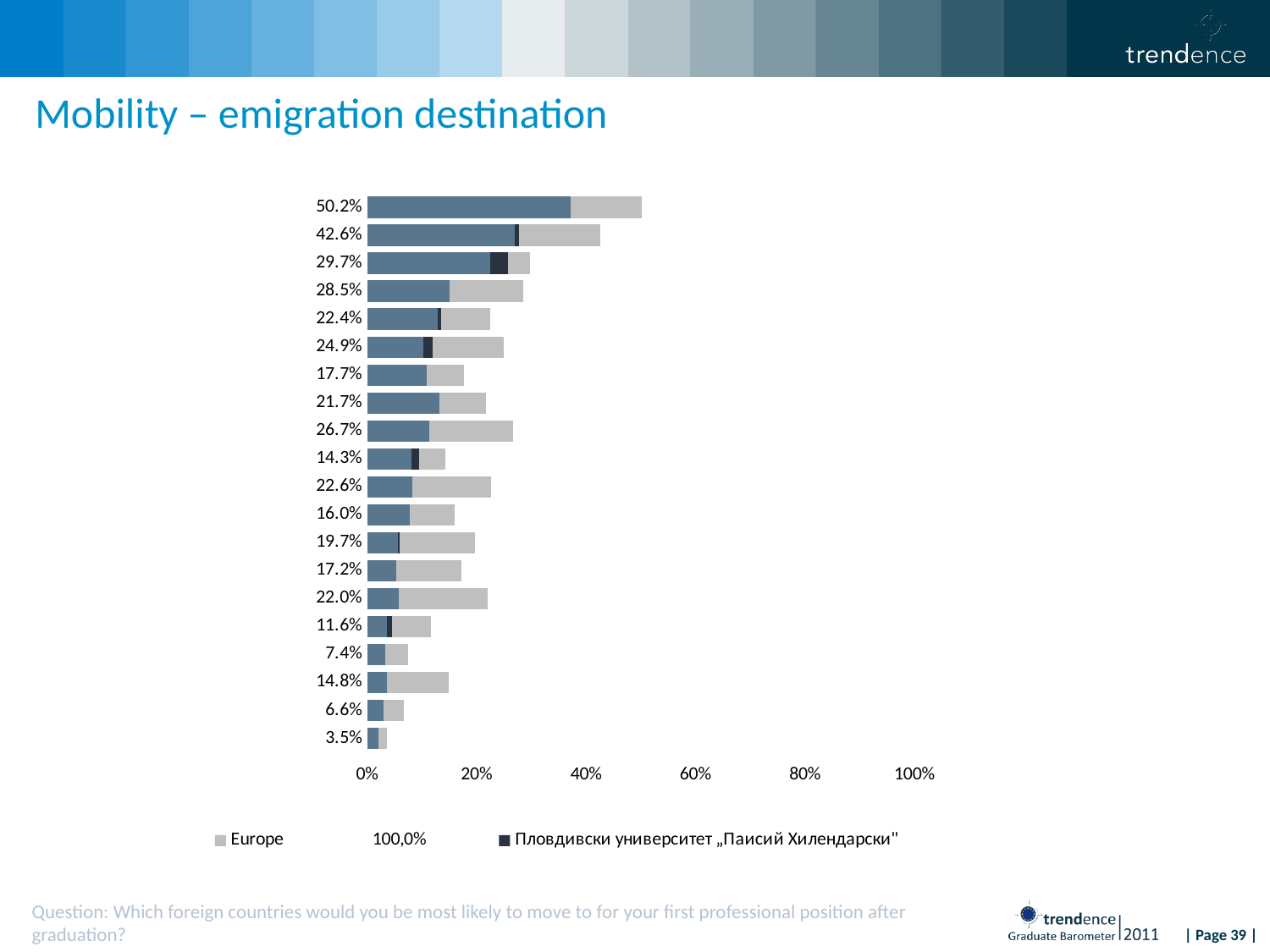
What is the highest value printed on the chart? 50.2% What is the difference between the highest printed value (50.2%) and the lowest printed value (3.5%)? 46.7% Is the value printed for the top bar greater or less than 40%? greater What is the lowest value printed on the chart? 3.5% What is the title of the chart on the slide? Mobility – emigration destination Which is larger, the value printed for the top bar (50.2%) or the value printed for the third bar (29.7%)? 50.2% What value is printed next to the top bar of the chart? 50.2% What is the maximum value shown on the horizontal axis? 100% What kind of chart is shown on the slide? bar chart What value is printed next to the second bar from the top? 42.6%